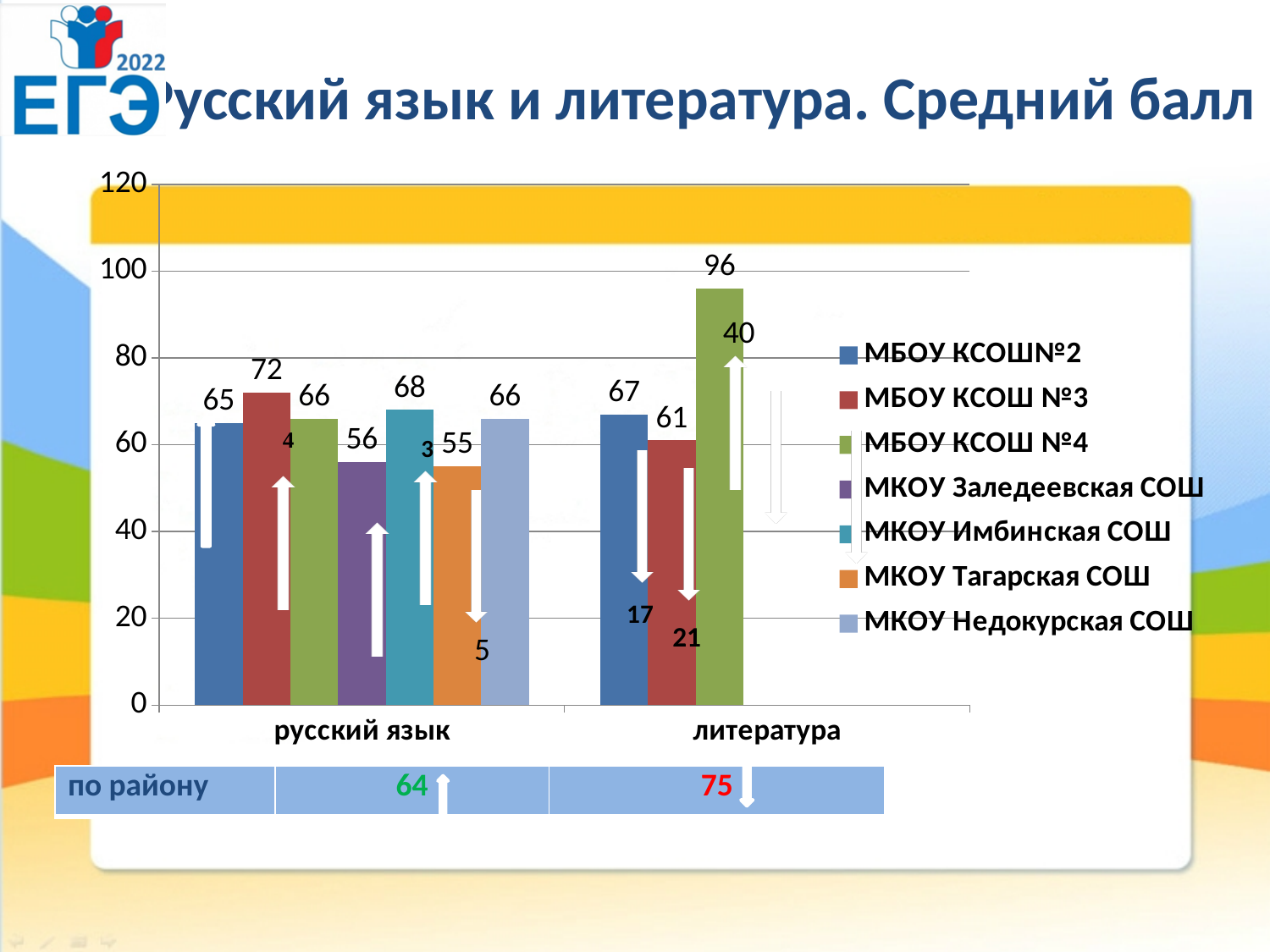
What is the value for МБОУ КСОШ №4 in the литература category? 96 What is the value for МБОУ КСОШ №2 in the литература category? 67 What is the value for МБОУ КСОШ №3 in the русский язык category? 72 How many categories are shown on the x axis? 2 Is the value for МБОУ КСОШ №4 in the литература category greater or less than 80? greater What type of chart is shown on the slide? bar chart Which school has the highest value in the русский язык category? МБОУ КСОШ №3 Which school has the lowest value in the русский язык category? МКОУ Тагарская СОШ What is the value for МКОУ Заледеевская СОШ in the русский язык category? 56 What is the difference between МБОУ КСОШ №4 and МБОУ КСОШ №3 in the литература category? 35 Which is larger in the русский язык category: МКОУ Имбинская СОШ or МКОУ Тагарская СОШ? МКОУ Имбинская СОШ How many series does the legend list? 7